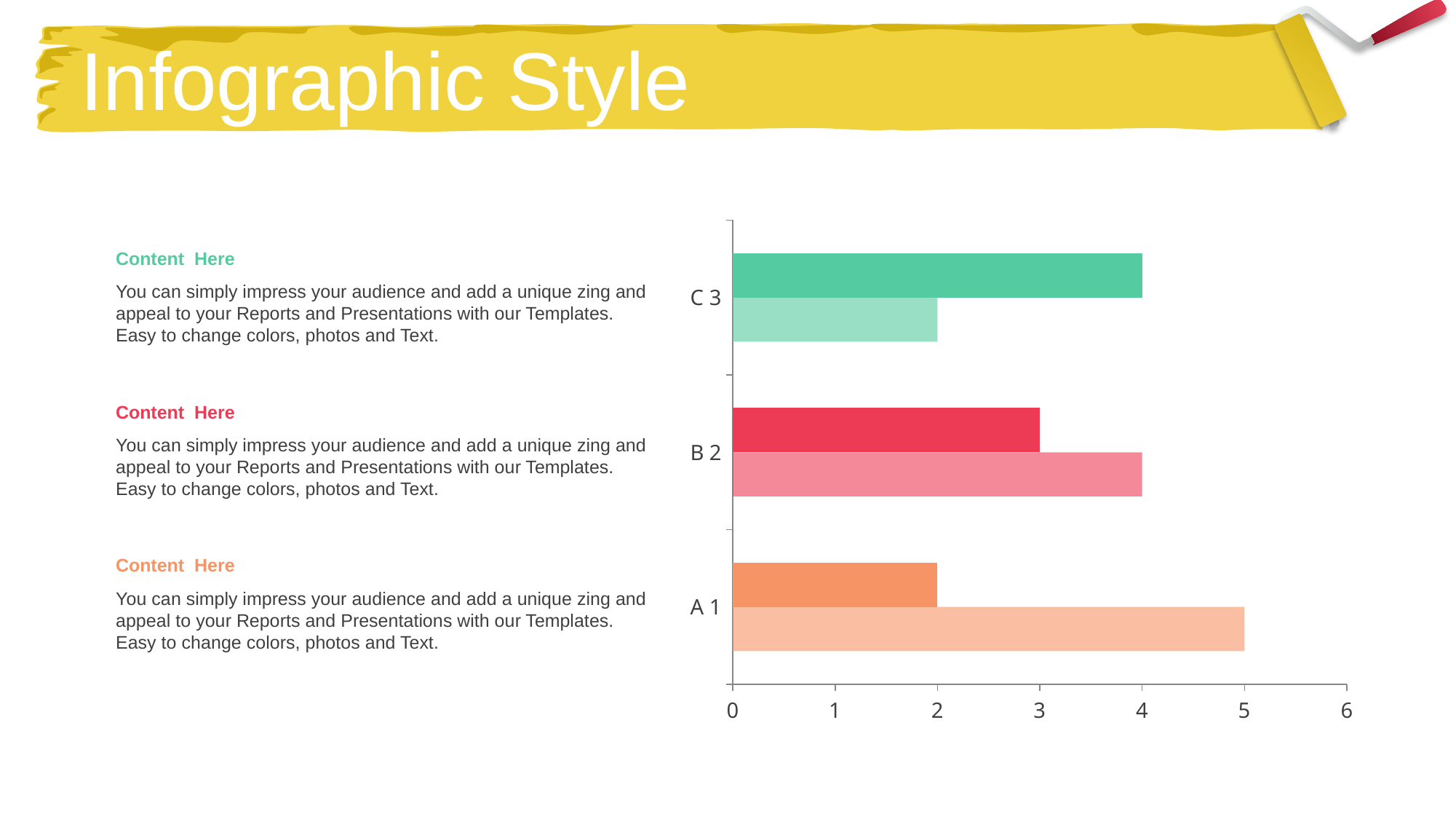
Which category has the longest lighter (lower) bar? A 1 What is the highest value shown on the chart's horizontal axis? 6 What kind of chart is shown on the slide? bar chart Which category has the shortest darker (upper) bar? A 1 What is the difference between the lighter bar and the darker bar for category A 1? 3 What is the value of the lighter (lower) bar for category A 1? 5 What is the value of the lighter (lower) bar for category C 3? 2 For category B 2, which is larger: the darker bar or the lighter bar? the lighter bar How many categories are shown on the chart's vertical axis? 3 What is the value of the darker (upper) bar for category C 3? 4 What is the value of the darker (upper) bar for category B 2? 3 What colour are the bars for category C 3? green